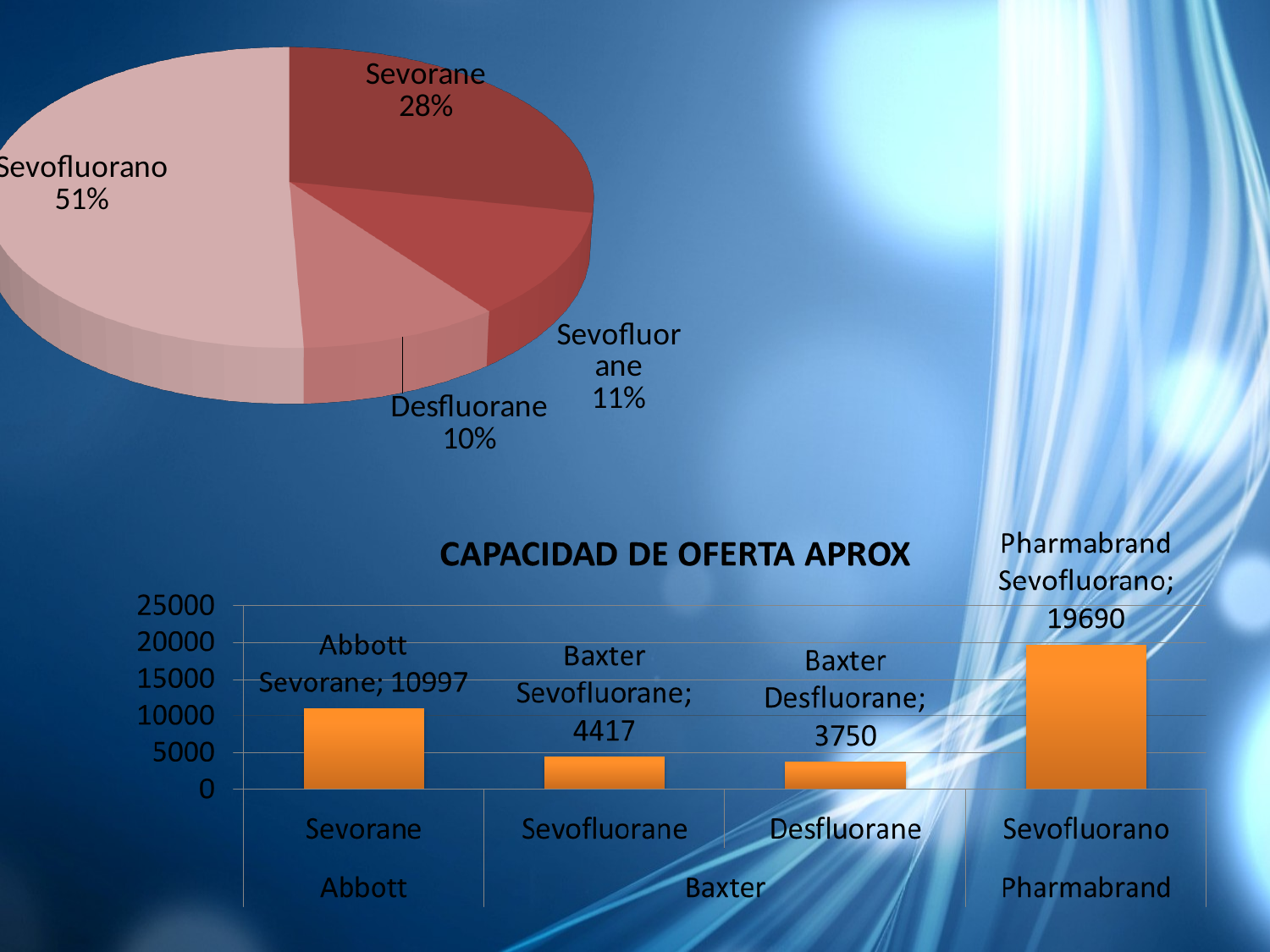
In the chart titled CAPACIDAD DE OFERTA APROX, which category has the lowest value? Baxter Desfluorane In the pie chart at the top left, which slice is the largest? Sevofluorano In the chart titled CAPACIDAD DE OFERTA APROX, what is the difference between Abbott Sevorane and Baxter Sevofluorane? 6580 In the chart titled CAPACIDAD DE OFERTA APROX, which category has the highest value? Pharmabrand Sevofluorano In the pie chart at the top left, how many slices are there? 4 What kind of chart is the one titled CAPACIDAD DE OFERTA APROX? Bar chart In the chart titled CAPACIDAD DE OFERTA APROX, which is larger: Abbott Sevorane or Baxter Sevofluorane? Abbott Sevorane In the chart titled CAPACIDAD DE OFERTA APROX, what is the value for Baxter Desfluorane? 3750 In the pie chart at the top left, what share does Sevorane have? 28% In the pie chart at the top left, what share does Sevofluorano have? 51% In the pie chart at the top left, which slice is the smallest? Desfluorane In the chart titled CAPACIDAD DE OFERTA APROX, what is the value for Pharmabrand Sevofluorano? 19690